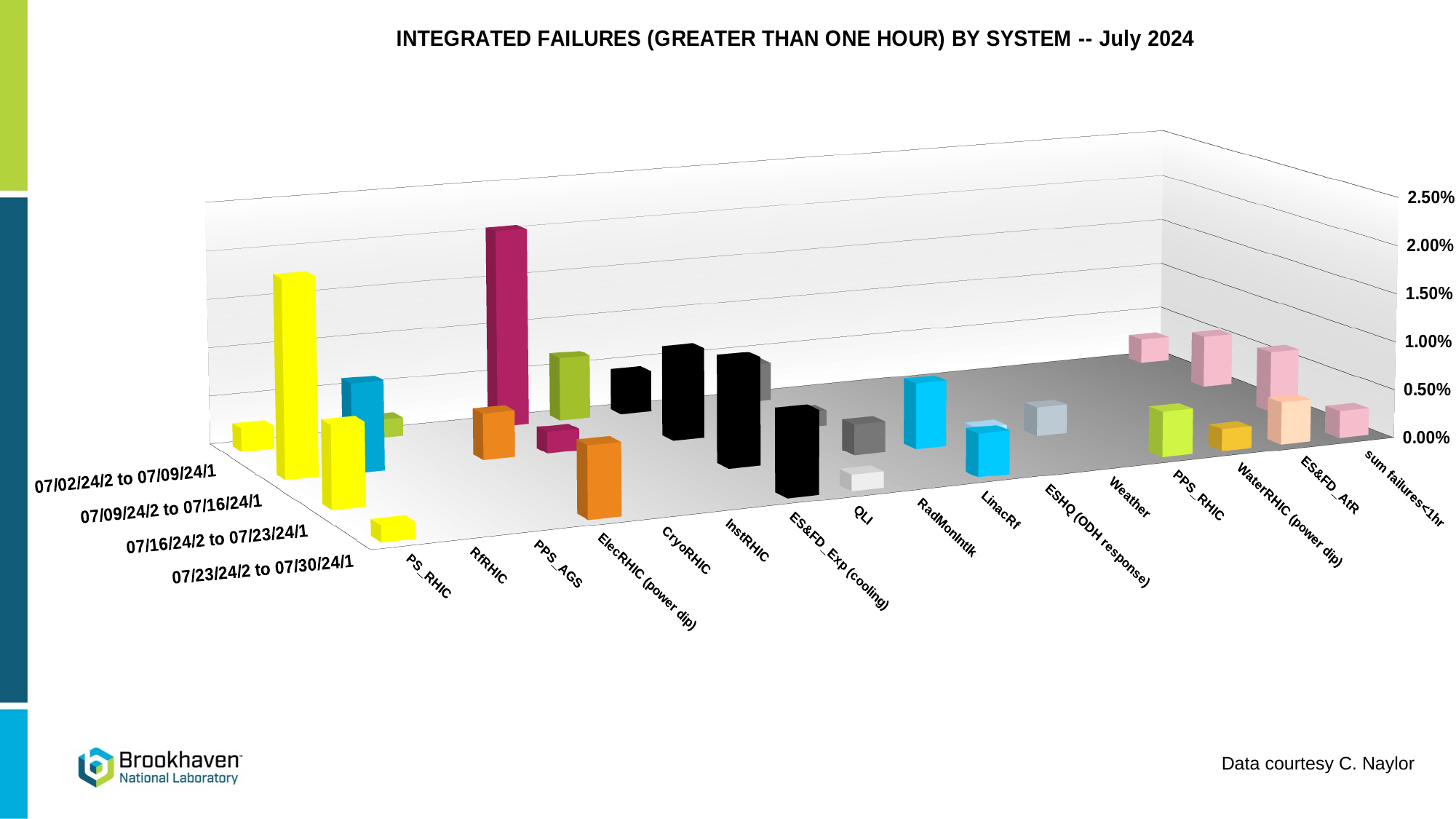
Is the tallest bar for ESHQ (ODH response) greater or less than 1.00%? less Which system has the tallest bar in the chart? CryoRHIC How many systems (categories) are listed along the horizontal axis of the chart? 16 Which has the taller tallest bar, RfRHIC or QLI? RfRHIC Is the tallest bar for QLI greater or less than 0.50%? less What is the title of the chart? INTEGRATED FAILURES (GREATER THAN ONE HOUR) BY SYSTEM -- July 2024 What kind of chart is shown on the slide? bar chart Is the tallest bar for RfRHIC greater or less than 1.50%? less What is the highest value shown on the vertical axis of the chart? 2.50% How many weekly periods are plotted along the depth axis of the chart? 4 Which system is listed last (rightmost) on the horizontal axis? sum failures<1hr